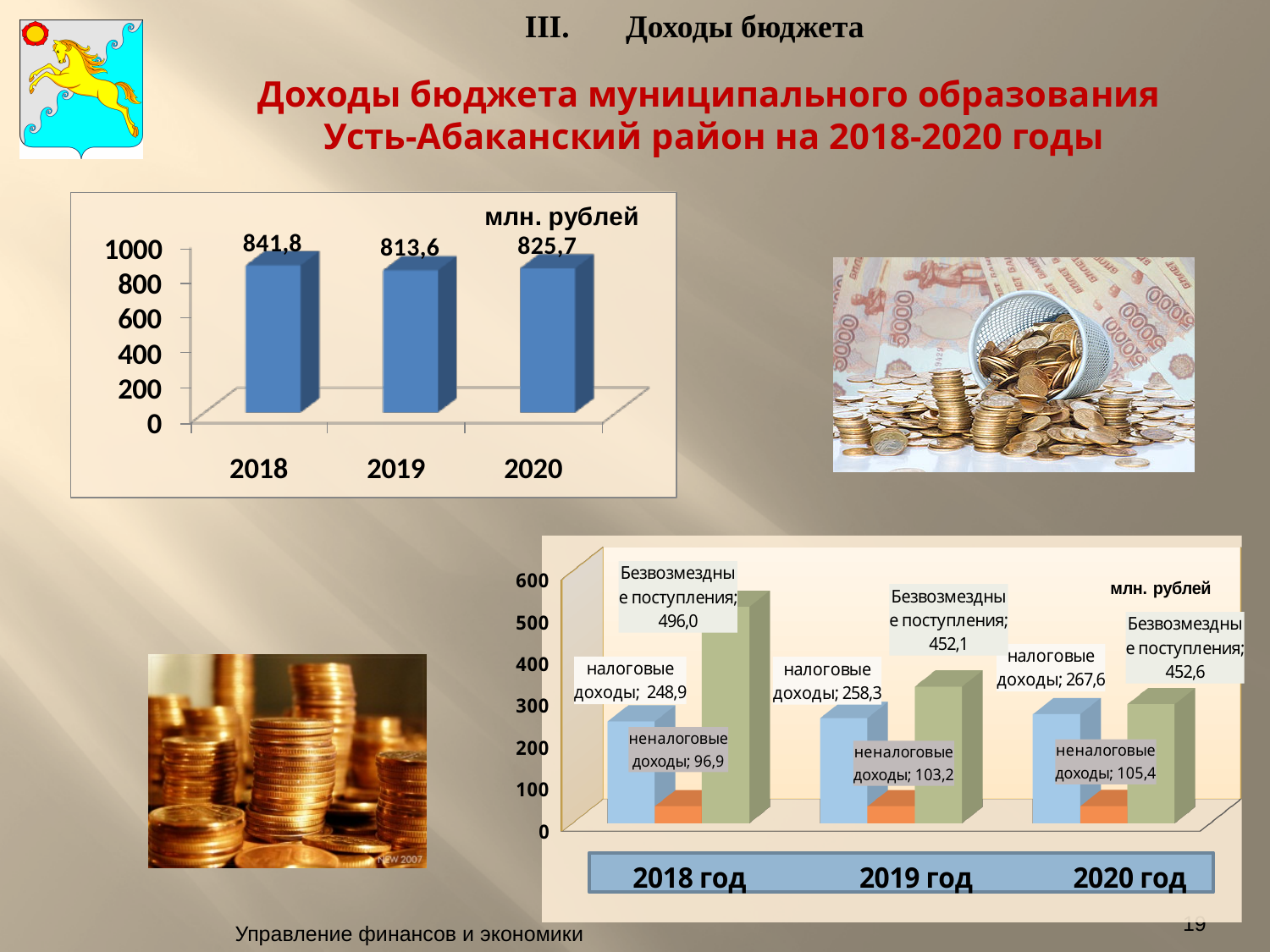
What kind of chart is the top-left chart? bar chart In the top-left chart, how many years are shown? 3 In the top-left chart, what is the value for 2018? 841,8 In the bottom-right chart, what is the value of неналоговые доходы for 2019 год? 103,2 In the top-left chart, what unit is stated above the bars? млн. рублей In the bottom-right chart, what is the value of безвозмездные поступления for 2018 год? 496,0 In the top-left chart, which year has the lowest value? 2019 In the top-left chart, which year has the highest value? 2018 In the bottom-right chart, do the values of налоговые доходы rise or fall from 2018 год to 2020 год? rise In the top-left chart, what is the difference between the values for 2018 and 2019? 28,2 In the bottom-right chart, what is the difference between налоговые доходы in 2020 год and 2018 год? 18,7 In the top-left chart, what is the value for 2020? 825,7